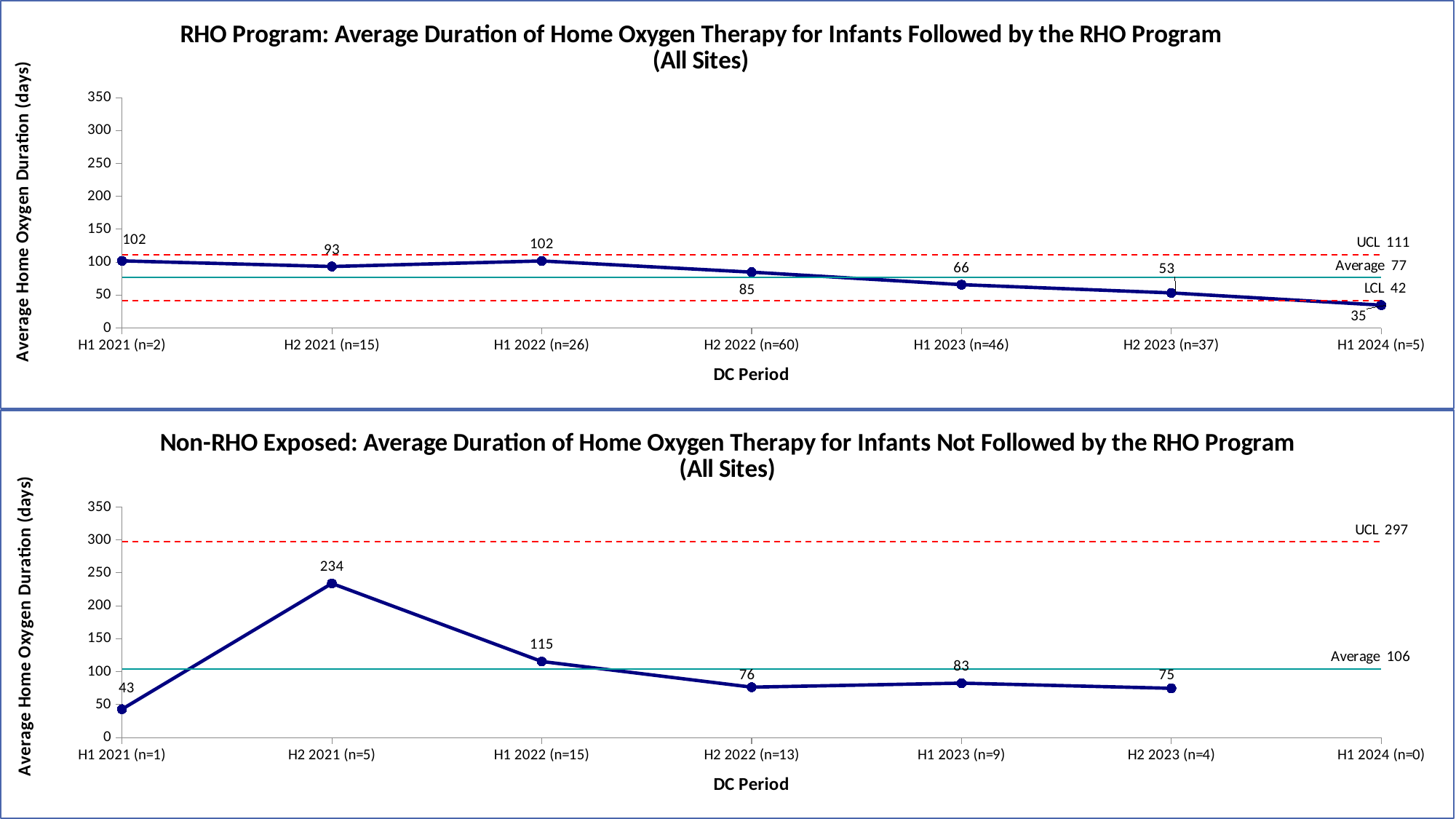
In the top chart (RHO Program), what is the difference between the values for H1 2022 (n=26) and H2 2023 (n=37)? 49 In the bottom chart (Non-RHO Exposed), which DC period has the highest average home oxygen duration? H2 2021 (n=5) In the top chart (RHO Program), do the values generally rise or fall from H1 2022 to H1 2024? fall In the top chart (RHO Program), what is the UCL value shown? 111 In the top chart (RHO Program), how many data points are plotted on the line? 7 In the top chart (RHO Program), what is the value for H1 2024 (n=5)? 35 What type of chart is used in both charts on the slide? line chart In the top chart (RHO Program), what is the average home oxygen duration for H2 2022 (n=60)? 85 In the bottom chart (Non-RHO Exposed), what is the difference between the values for H2 2021 (n=5) and H1 2021 (n=1)? 191 In the top chart (RHO Program), which DC period has the lowest average home oxygen duration? H1 2024 (n=5) In the bottom chart (Non-RHO Exposed), which is larger: the value for H1 2023 (n=9) or H2 2023 (n=4)? H1 2023 (n=9) In the bottom chart (Non-RHO Exposed), what is the value for H1 2022 (n=15)? 115